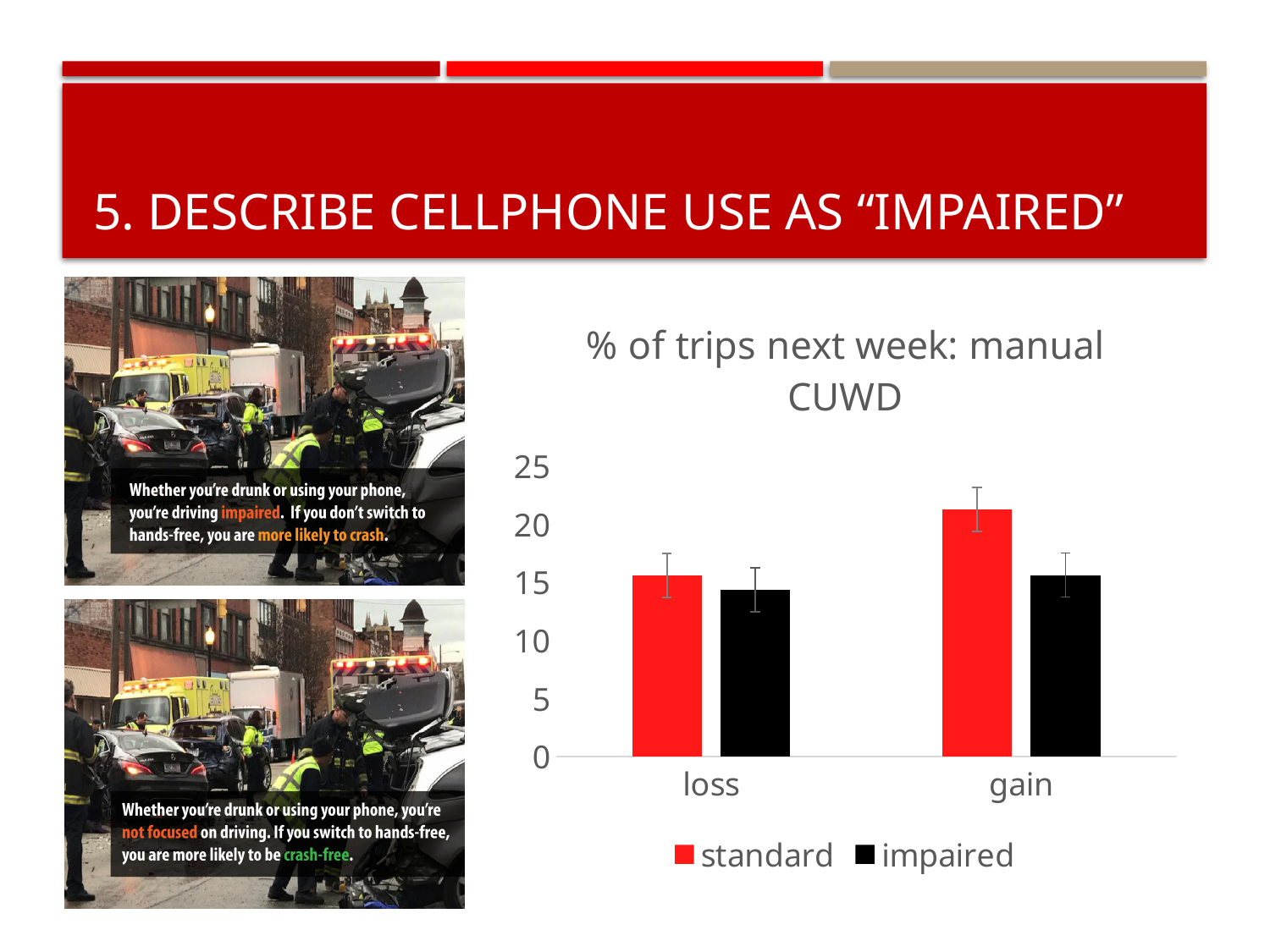
How many categories are shown on the x axis of the chart? 2 In the "gain" category, which series has the larger value, standard or impaired? standard For the "standard" series, which category has the larger value, loss or gain? gain Which category and series combination has the highest bar in the chart? gain, standard What is the title of the chart? % of trips next week: manual CUWD Which colour represents the "impaired" series in the chart? black How many series does the chart's legend list? 2 Is the value for "impaired" in the "gain" category greater or less than 20? less Is the value for "standard" in the "loss" category greater or less than 20? less Is the value for "standard" in the "gain" category greater or less than 20? greater What kind of chart is shown on the slide? bar chart